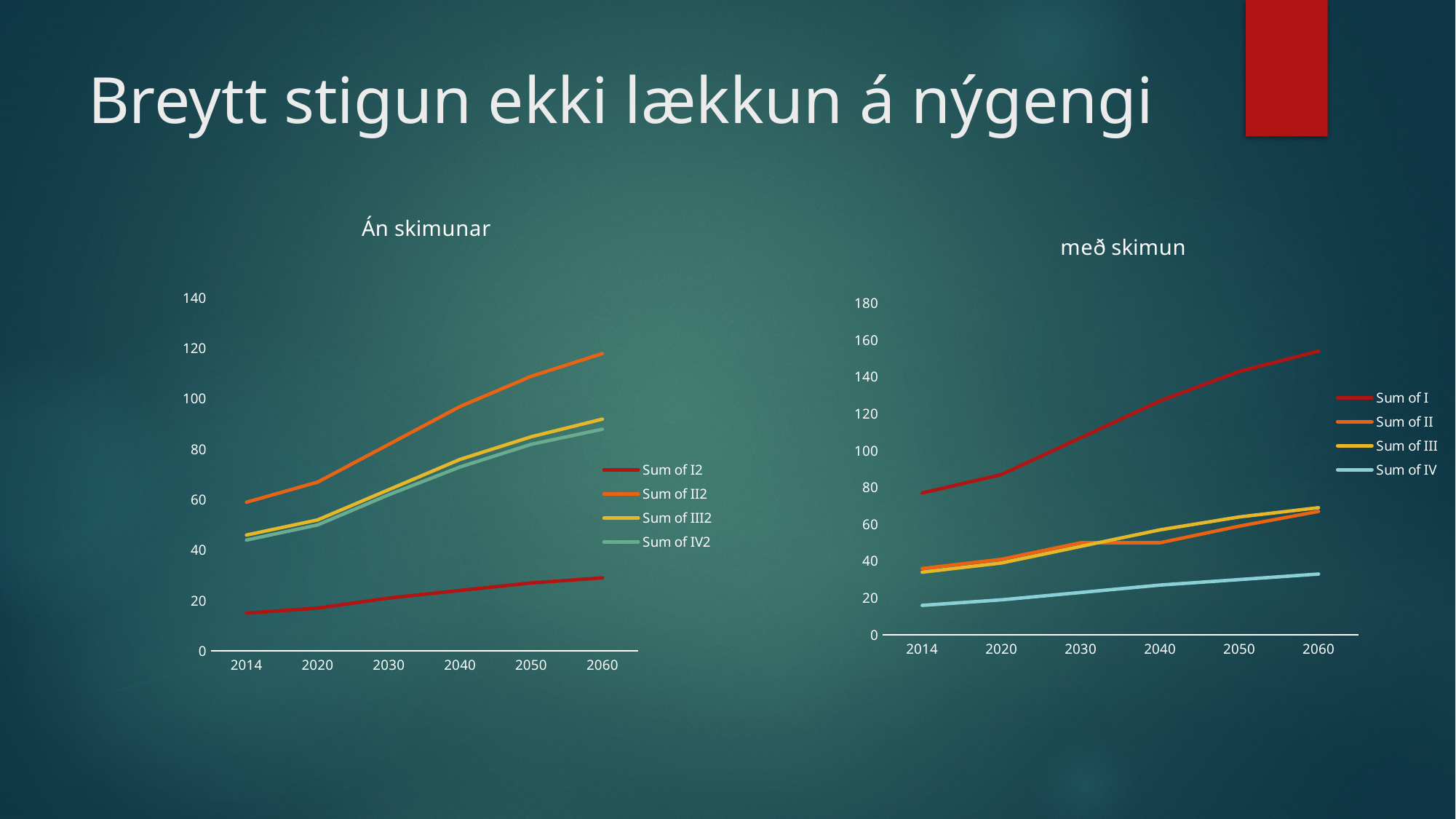
How many series does the legend of the "Án skimunar" chart list? 4 In the "með skimun" chart, which series has the highest value in 2060? Sum of I In the "Án skimunar" chart, is the value for Sum of I2 in 2014 greater or less than 20? less In the "Án skimunar" chart, which series has the lowest value in 2060? Sum of I2 What kind of chart is the "Án skimunar" chart? line chart In the "Án skimunar" chart, is the value for Sum of II2 in 2060 greater or less than 100? greater In the "Án skimunar" chart, which series has the highest value in 2060? Sum of II2 In the "með skimun" chart, is the value for Sum of I in 2060 greater or less than 140? greater In the "með skimun" chart, does the Sum of I series rise or fall from 2014 to 2060? rise How many years are shown on the x axis of the "með skimun" chart? 6 In the "með skimun" chart, which is larger in 2040: Sum of I or Sum of IV? Sum of I